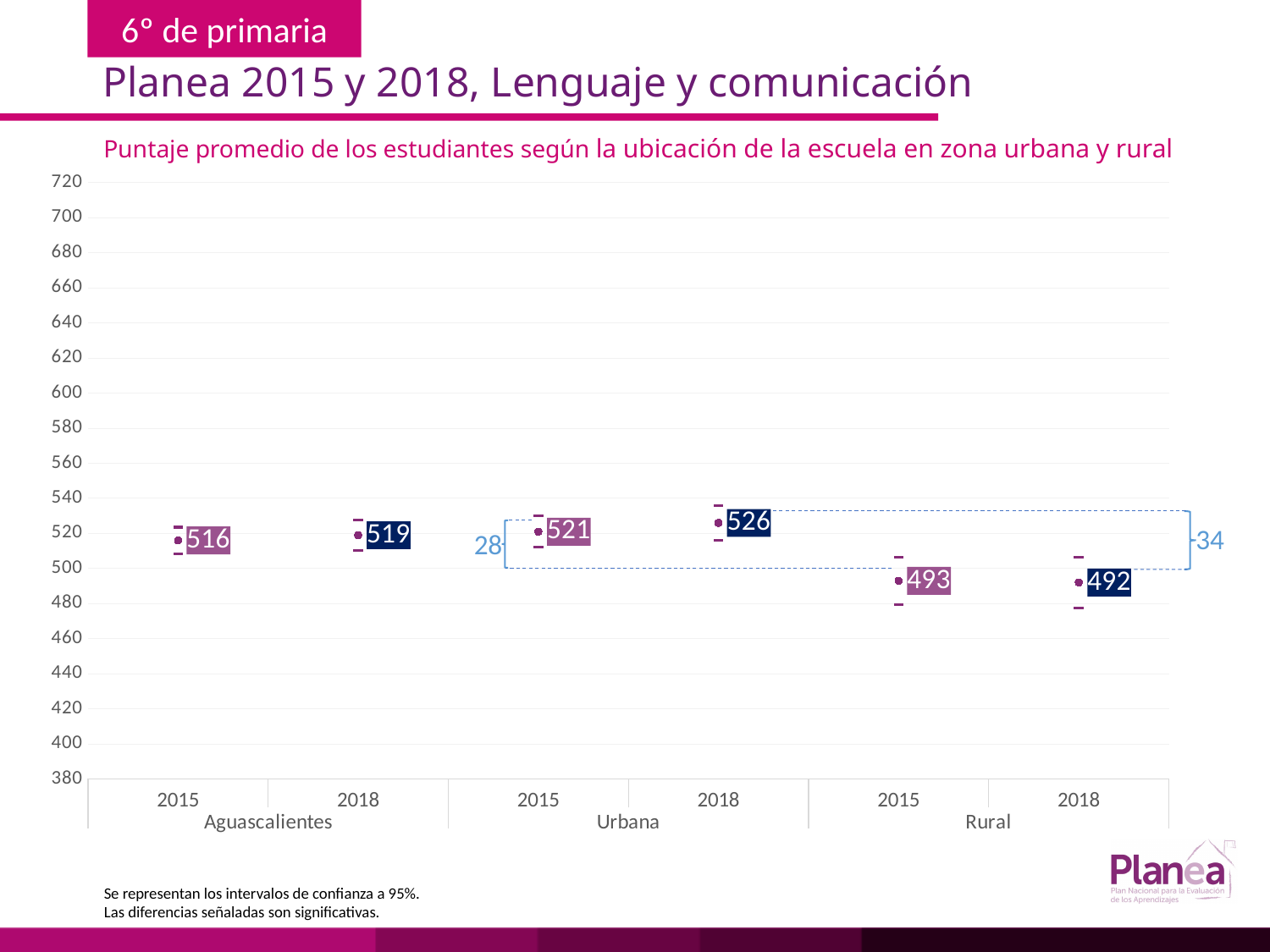
What is the difference between the Urbana and Rural average scores in 2018? 34 What is the difference between the Urbana and Rural average scores in 2015? 28 What is the average score for Aguascalientes in 2015? 516 What is the average score for Aguascalientes in 2018? 519 Which is larger, the Urbana score in 2015 or the Aguascalientes score in 2015? Urbana 2015 Which group and year has the highest average score? Urbana 2018 Which group and year has the lowest average score? Rural 2018 What is the average score for Urbana schools in 2018? 526 What is the average score for Rural schools in 2015? 493 Is the Rural score for 2018 greater or less than 500? less How many data points are plotted on the chart? 6 What is the title of the chart? Puntaje promedio de los estudiantes según la ubicación de la escuela en zona urbana y rural